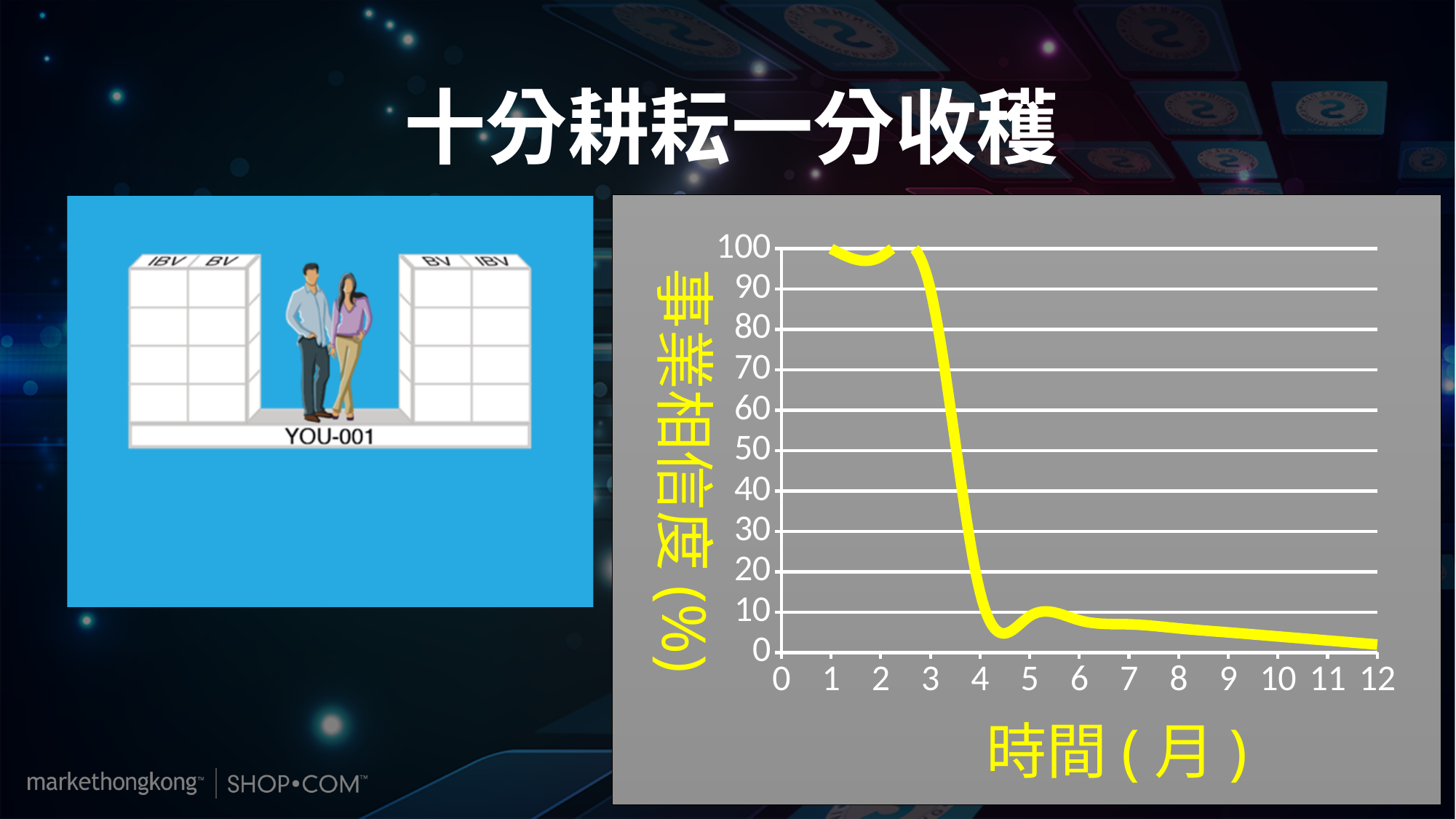
Which is larger, the value at month 2 or the value at month 6? month 2 What kind of chart is shown on the slide? line chart Is the value at month 12 greater or less than 10? less Between which two months does the line drop most sharply? 3 and 4 Is the value at month 8 greater or less than 20? less What is the highest value shown on the y axis of the chart? 100 Do the values rise or fall along the x axis from month 2 to month 12? fall What is the label of the x axis of the chart? 時間(月) Is the value at month 5 greater or less than 50? less What is the label of the y axis of the chart? 事業相信度 (%)